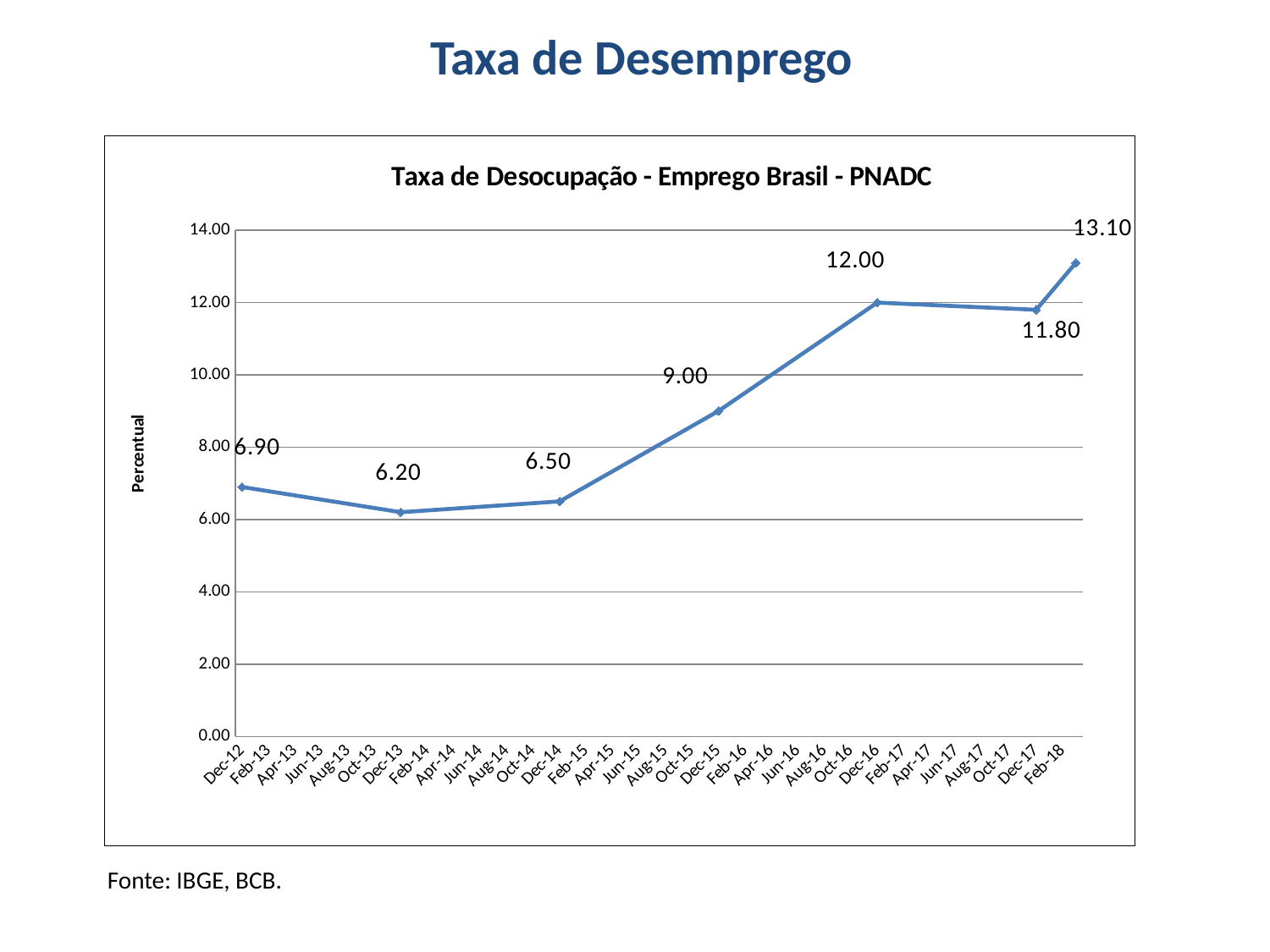
Which point has the lowest value? Dec-13 Is the value for Dec-15 greater or less than 10.00? less What is the value for Dec-12? 6.90 What is the chart's title? Taxa de Desocupação - Emprego Brasil - PNADC What kind of chart is shown? line chart Which point has the highest value? Feb-18 How many data points are plotted on the line? 7 Which is larger, the value for Dec-14 or the value for Dec-13? Dec-14 What is the difference between the values for Dec-16 and Dec-15? 3.00 What is the value for Dec-16? 12.00 What is the value for Dec-17? 11.80 What is the value for Feb-18? 13.10